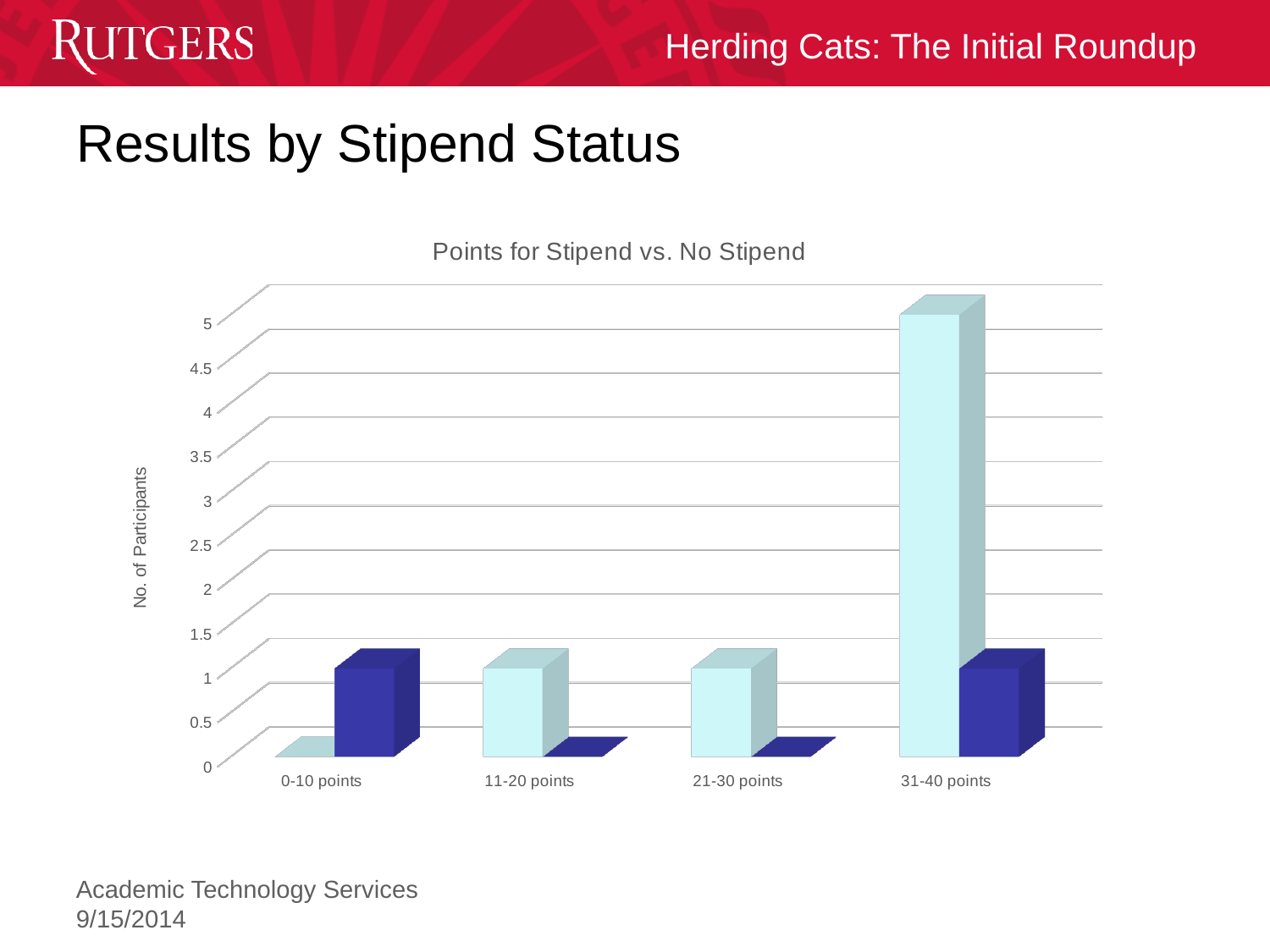
For 31-40 points, which bar is taller, the light blue bar or the dark blue bar? light blue Which category has the tallest bar in the chart? 31-40 points Is the dark blue bar for 0-10 points greater or less than 2? less Is the light blue bar for 31-40 points greater or less than 4? greater What is the label of the vertical axis? No. of Participants Is the light blue bar for 11-20 points greater or less than 2? less What type of chart is shown on the slide? bar chart What is the title of the chart? Points for Stipend vs. No Stipend How many point-range categories are shown on the x axis? 4 For 0-10 points, which bar is taller, the light blue bar or the dark blue bar? dark blue